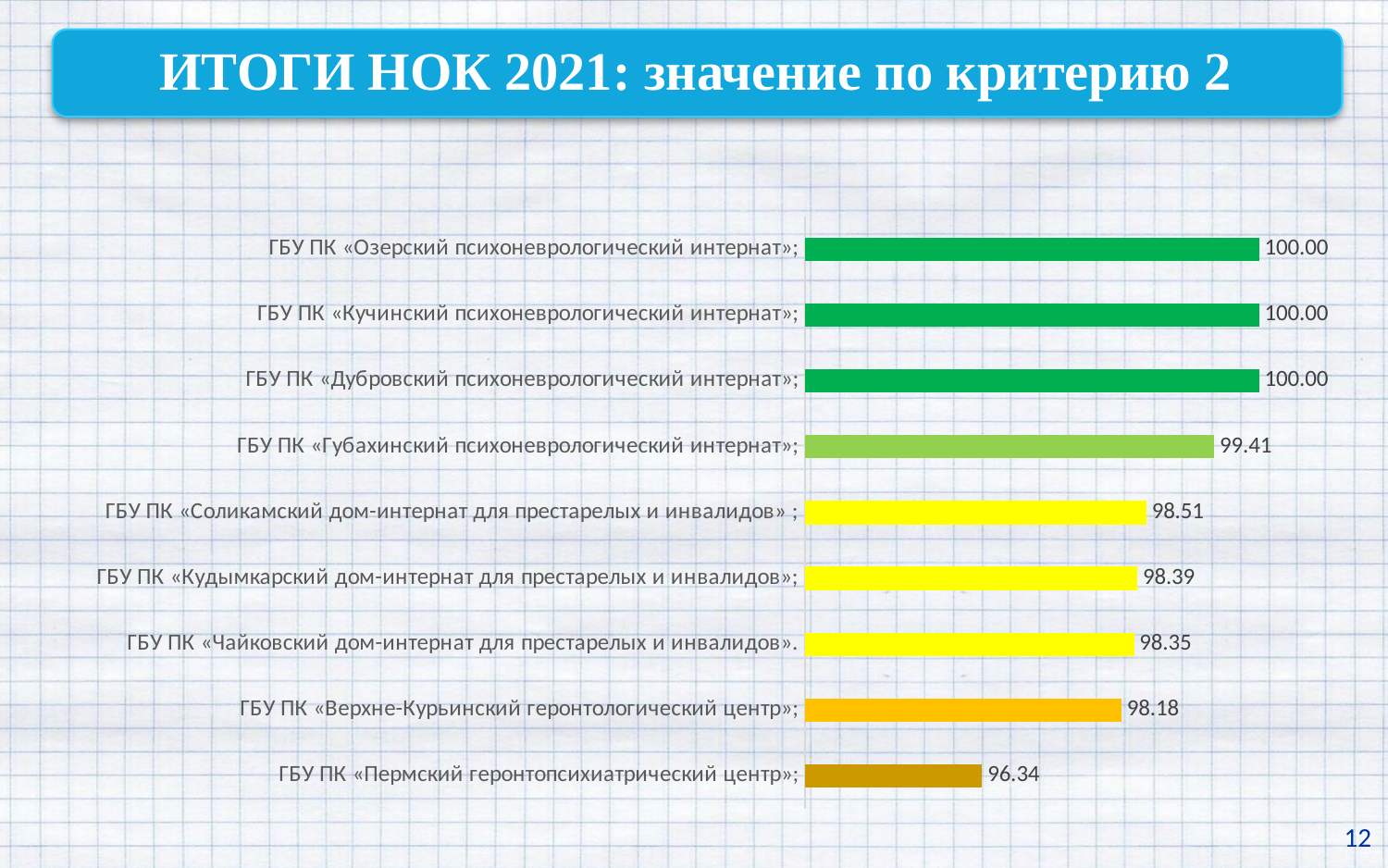
Which is larger: the value for ГБУ ПК «Кудымкарский дом-интернат для престарелых и инвалидов» or ГБУ ПК «Пермский геронтопсихиатрический центр»? ГБУ ПК «Кудымкарский дом-интернат для престарелых и инвалидов» What is the value for ГБУ ПК «Соликамский дом-интернат для престарелых и инвалидов»? 98.51 What is the difference between the values for ГБУ ПК «Озерский психоневрологический интернат» and ГБУ ПК «Пермский геронтопсихиатрический центр»? 3.66 What is the value for ГБУ ПК «Губахинский психоневрологический интернат»? 99.41 What is the highest value shown on the chart? 100.00 How many categories are shown on the chart? 9 Which category has the lowest value? ГБУ ПК «Пермский геронтопсихиатрический центр» What kind of chart is shown on the slide? Bar chart What is the title of the slide? ИТОГИ НОК 2021: значение по критерию 2 What is the difference between the values for ГБУ ПК «Губахинский психоневрологический интернат» and ГБУ ПК «Верхне-Курьинский геронтологический центр»? 1.23 What is the value for ГБУ ПК «Пермский геронтопсихиатрический центр»? 96.34 What is the value for ГБУ ПК «Верхне-Курьинский геронтологический центр»? 98.18